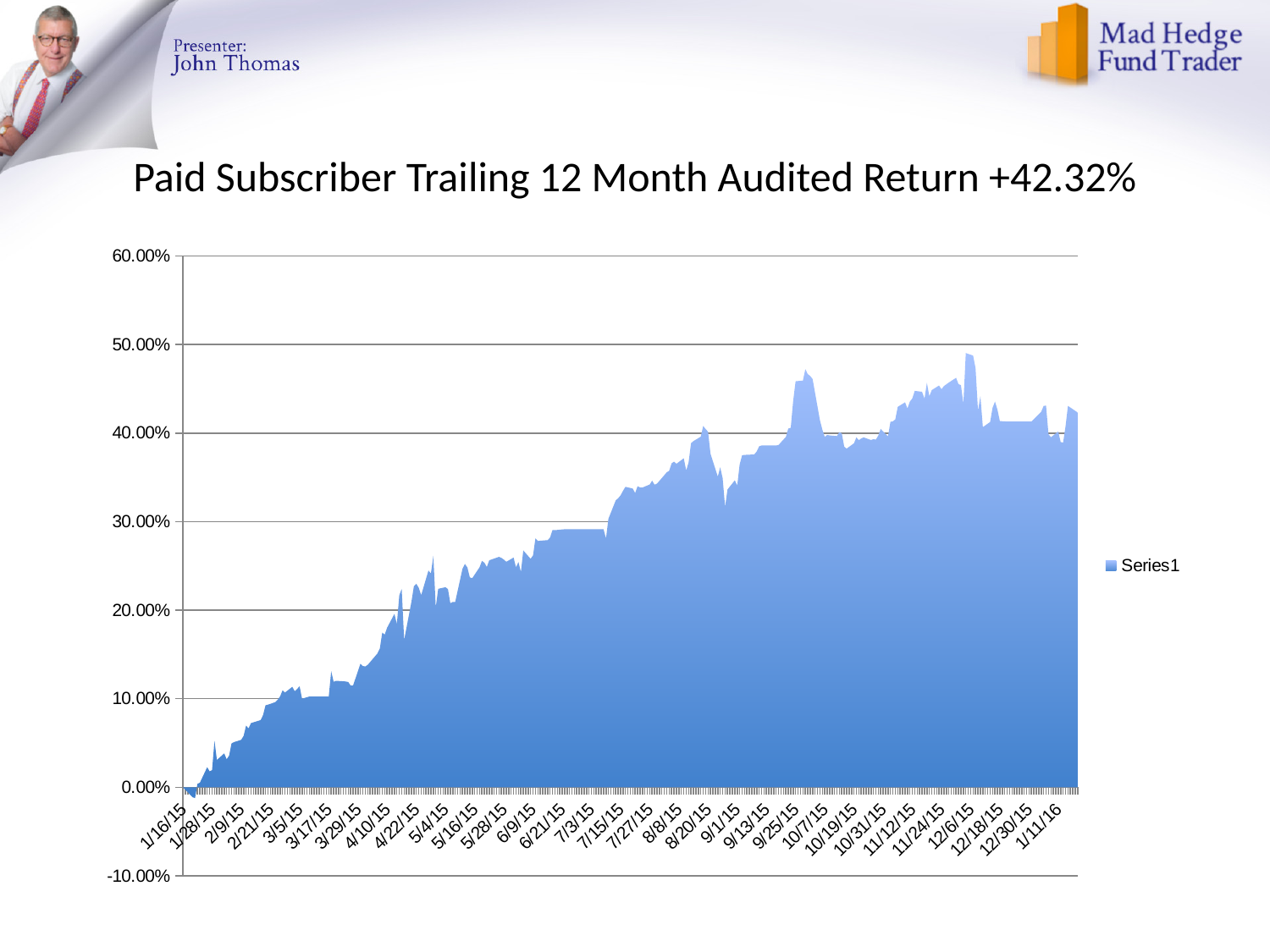
What is the name of the series shown in the legend? Series1 Is the value for 9/25/15 greater or less than 40.00%? greater What is the title of the chart on the slide? Paid Subscriber Trailing 12 Month Audited Return +42.32% Overall, do the values rise or fall from 1/16/15 to 1/11/16? Rise Is the value for 5/28/15 greater or less than 20.00%? greater How many series does the legend list? 1 What kind of chart is shown on the slide? Area chart Which is larger, the value for 3/17/15 or the value for 6/9/15? 6/9/15 Is the value for 7/27/15 greater or less than 30.00%? greater